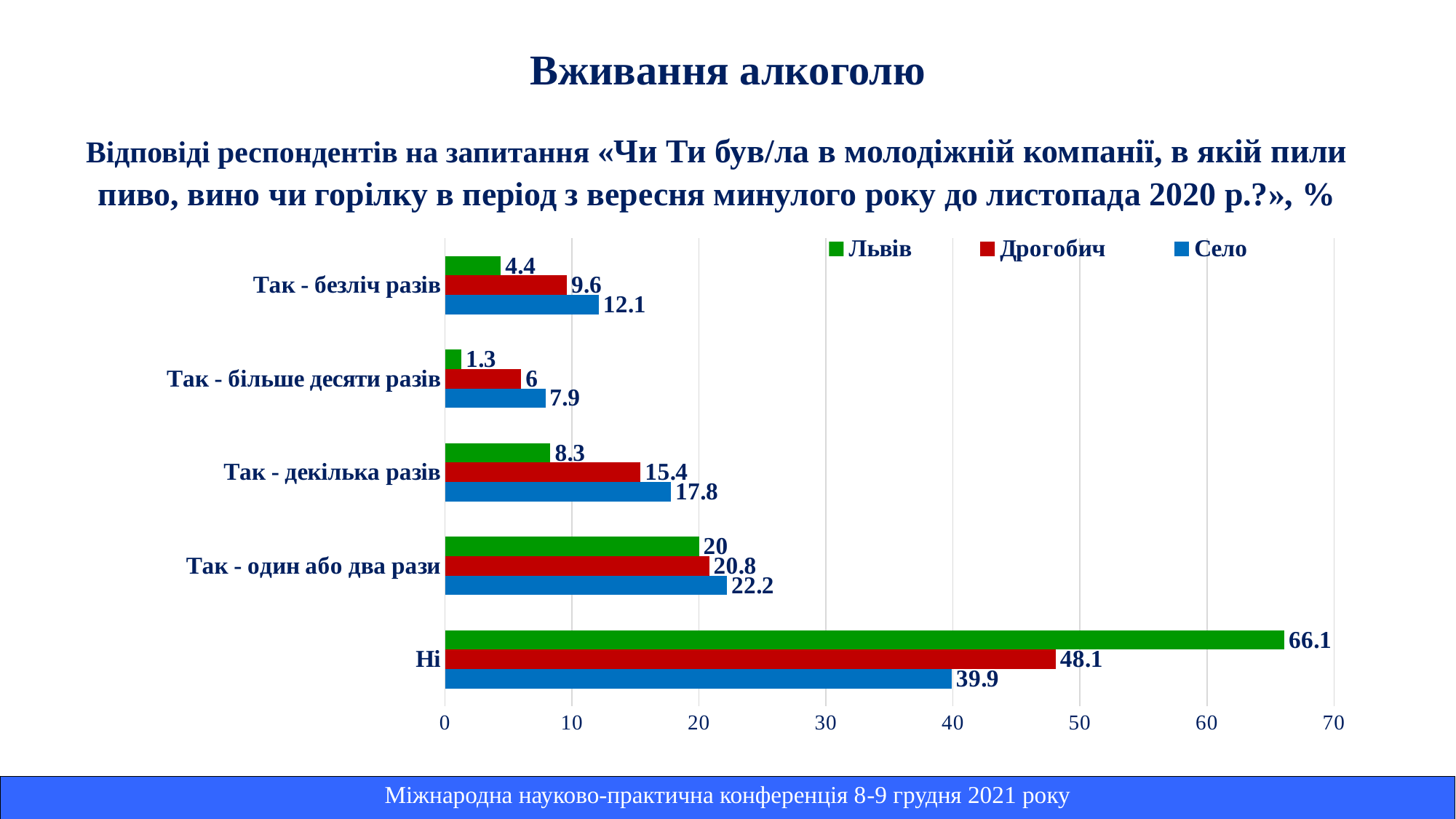
Is the value for Дрогобич in the category «Ні» greater or less than 40? greater Which category has the lowest value for Львів? Так - більше десяти разів Which colour represents the series Село in the chart? blue Which category has the highest value for Село? Ні What is the value for Дрогобич in the category «Так - більше десяти разів»? 6 What is the value for Село in the category «Так - безліч разів»? 12.1 How many categories are shown on the chart? 5 What is the value for Львів in the category «Ні»? 66.1 In the category «Так - декілька разів», which is larger: the value for Дрогобич or the value for Львів? Дрогобич How many series does the legend list? 3 What kind of chart is shown on the slide? bar chart What is the difference between the Львів and Село values in the category «Ні»? 26.2